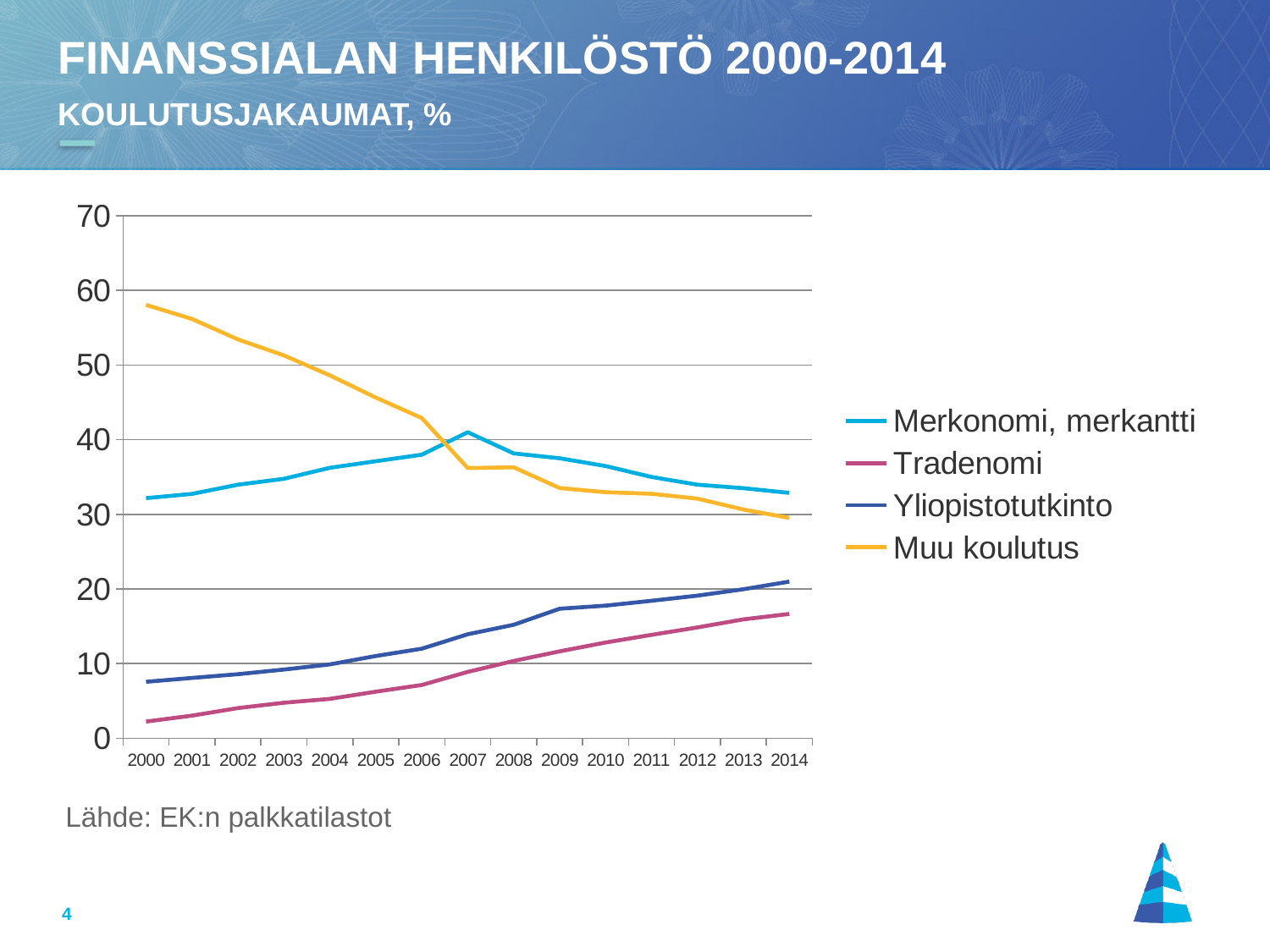
How many series does the legend list? 4 Does the Tradenomi line rise or fall from 2000 to 2014? rise Which series has the highest value in 2000? Muu koulutus Is the value for Yliopistotutkinto in 2000 greater or less than 10? less How many years are shown along the x axis? 15 Which series has the lowest value in 2000? Tradenomi In 2014, which is larger: Merkonomi, merkantti or Muu koulutus? Merkonomi, merkantti Does the Muu koulutus line rise or fall from 2000 to 2014? fall What kind of chart is shown on the slide? line chart Is the value for Tradenomi in 2014 greater or less than 20? less Is the value for Muu koulutus in 2000 greater or less than 50? greater Does the Yliopistotutkinto line rise or fall from 2000 to 2014? rise